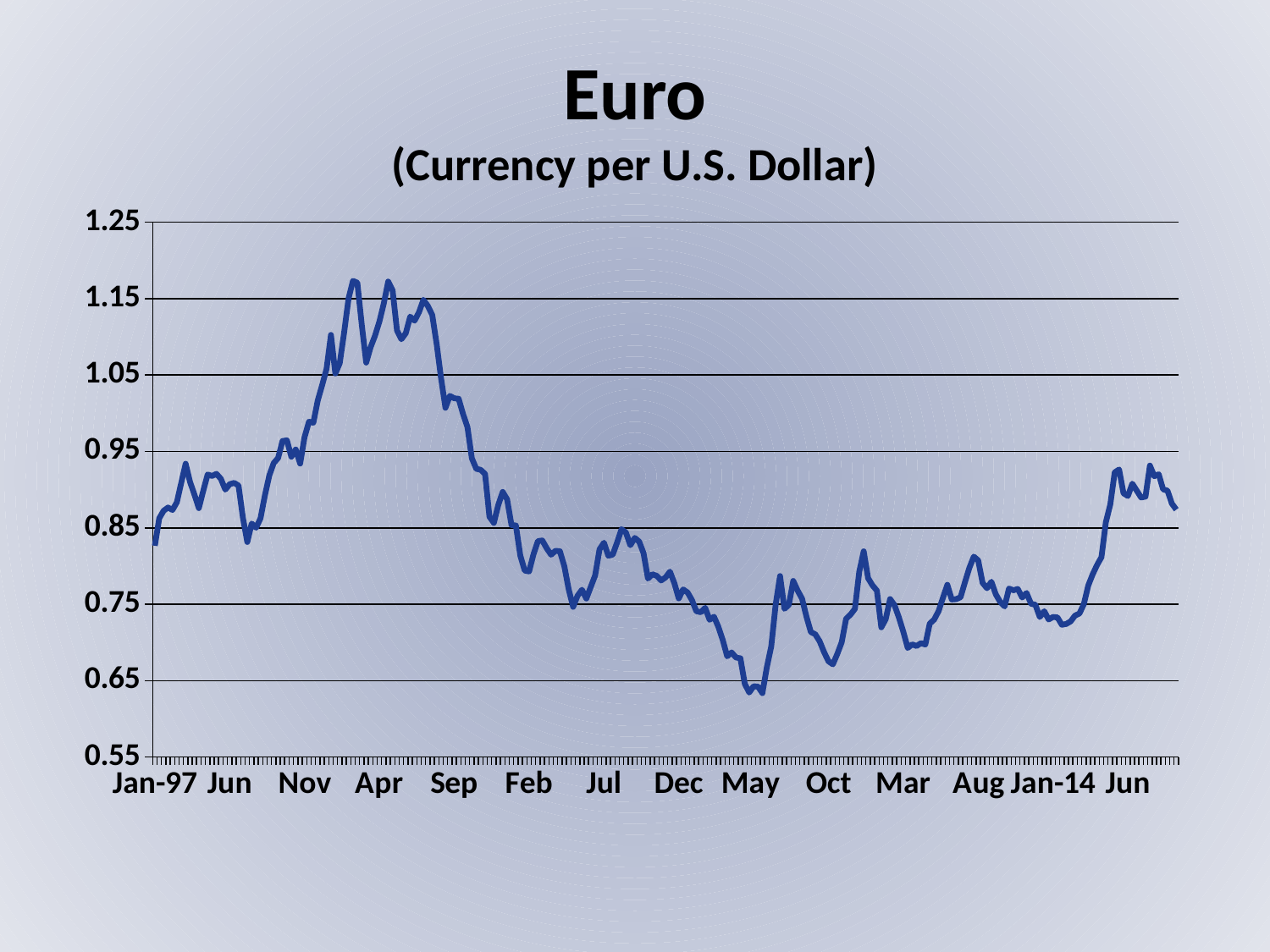
Is the value at Jan-14 greater or less than 0.75? less How many labels are shown along the x axis? 14 What is the highest value shown on the y axis? 1.25 Is the peak value of the line greater or less than 1.15? greater Does the line rise or fall between Jan-14 and the final Jun label? rise Is the value at Sep greater or less than 0.95? greater Does the line rise or fall between Apr and Feb? fall What is the title of the chart? Euro (Currency per U.S. Dollar) What kind of chart is shown on the slide? line chart How many data series are plotted on the chart? 1